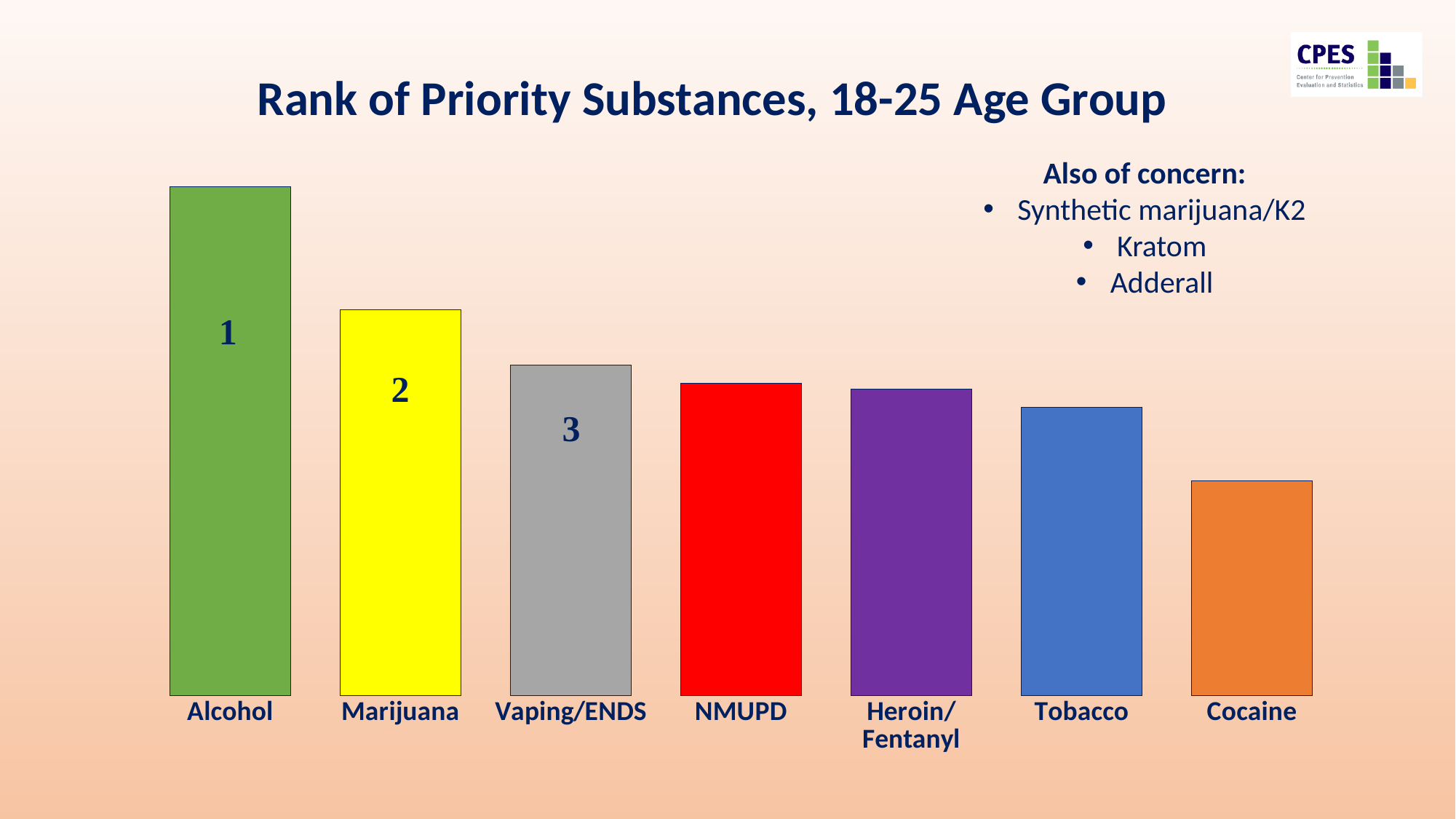
How many substances (bars) are shown in the chart? 7 What colour is the Alcohol bar? green What kind of chart is shown on the slide? bar chart What is the title of the chart? Rank of Priority Substances, 18-25 Age Group Which bar is taller, Marijuana or Tobacco? Marijuana Do the bars rise or fall from left to right across the chart? fall Which substance has the shortest bar in the chart? Cocaine Which substance is labelled with rank 3 in the chart? Vaping/ENDS What rank number is printed on the Alcohol bar? 1 Which substance has the tallest bar in the chart? Alcohol What rank number is printed on the Marijuana bar? 2 Which bar is taller, Tobacco or Cocaine? Tobacco